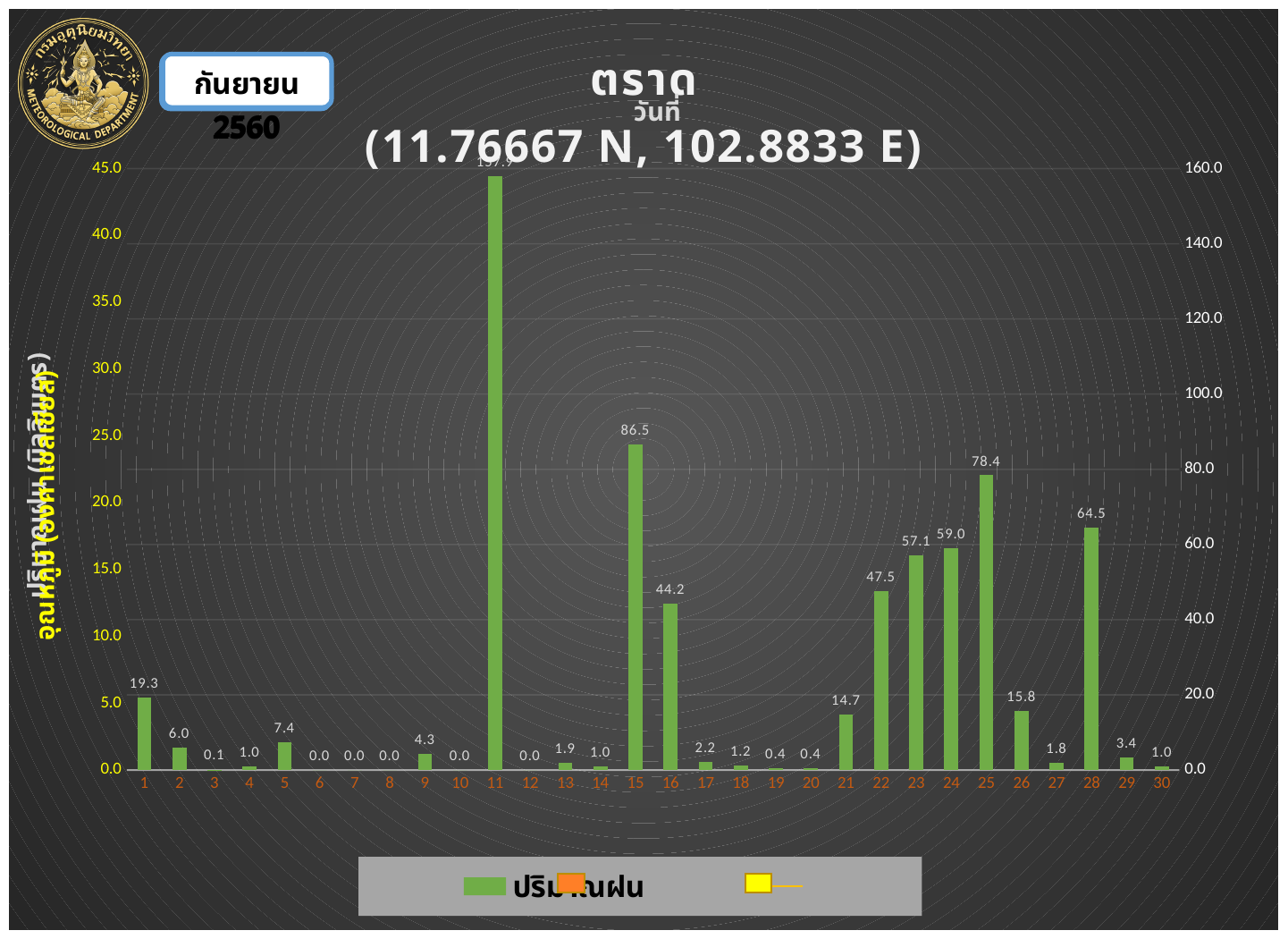
How many days (categories) are plotted on the x axis? 30 What is the value for day 28? 64.5 What is the station name shown in the chart title? ตราด Which day has the highest bar in the chart? 11 Which is larger, the value for day 22 or the value for day 26? day 22 What is the value for day 25? 78.4 What is the difference between the values for day 15 and day 16? 42.3 What is the difference between the values for day 24 and day 23? 1.9 Is the value for day 11 greater or less than 140.0 on the right axis? greater What is the value for day 1? 19.3 What type of chart is shown on the slide? bar chart What is the value for day 15? 86.5